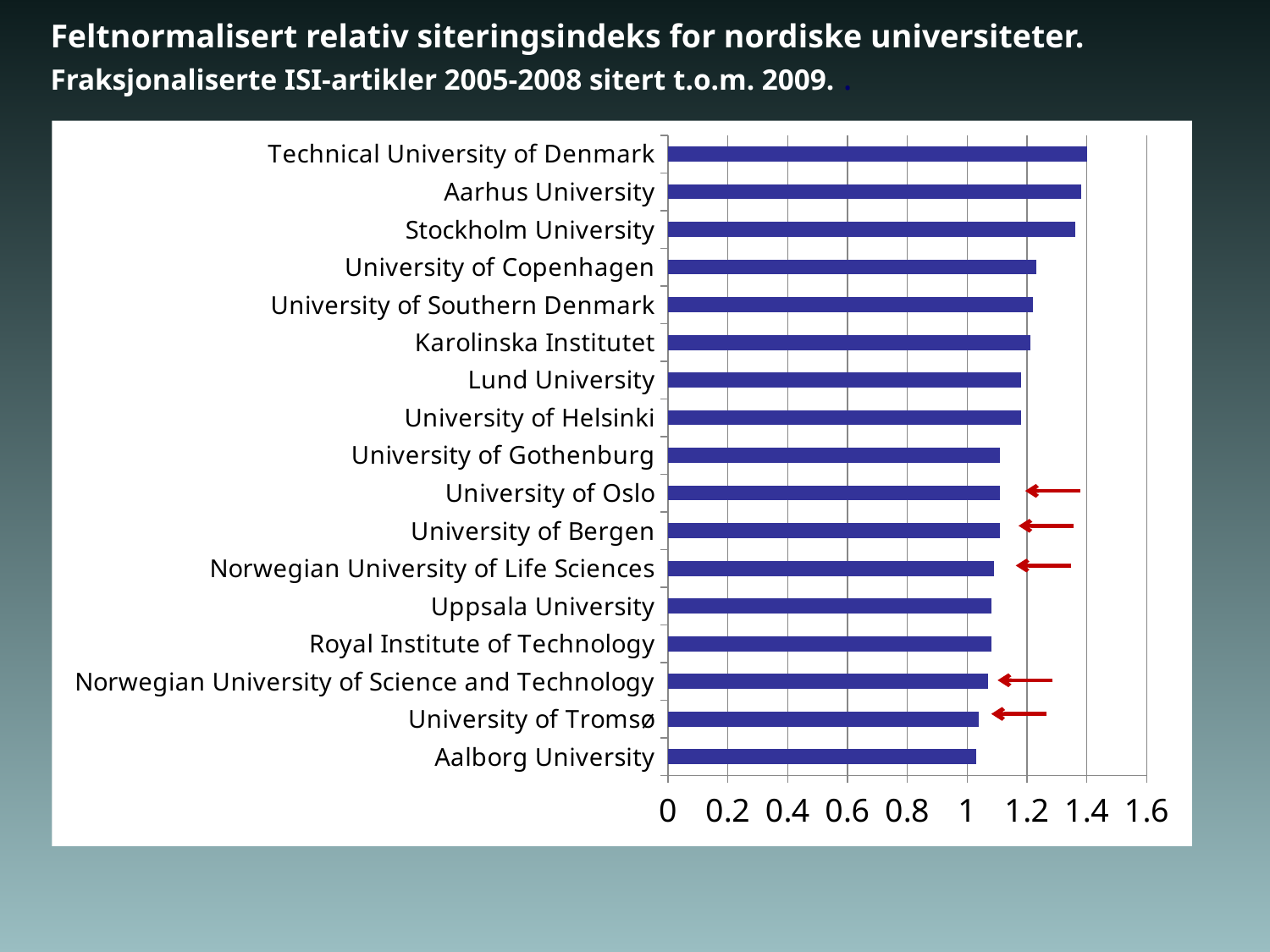
Which has the larger value, Aalborg University or University of Copenhagen? University of Copenhagen Which university has the highest citation index on the chart? Technical University of Denmark Do the bar values increase or decrease going from the top of the chart to the bottom? decrease Is the value for University of Oslo greater or less than 1? greater What kind of chart is shown on the slide? bar chart How many universities are marked with a red arrow on the chart? 5 Which has the larger value, Stockholm University or Uppsala University? Stockholm University Is the value for Aalborg University greater or less than 1.2? less Is the value for Stockholm University greater or less than 1.2? greater How many universities are listed on the chart? 17